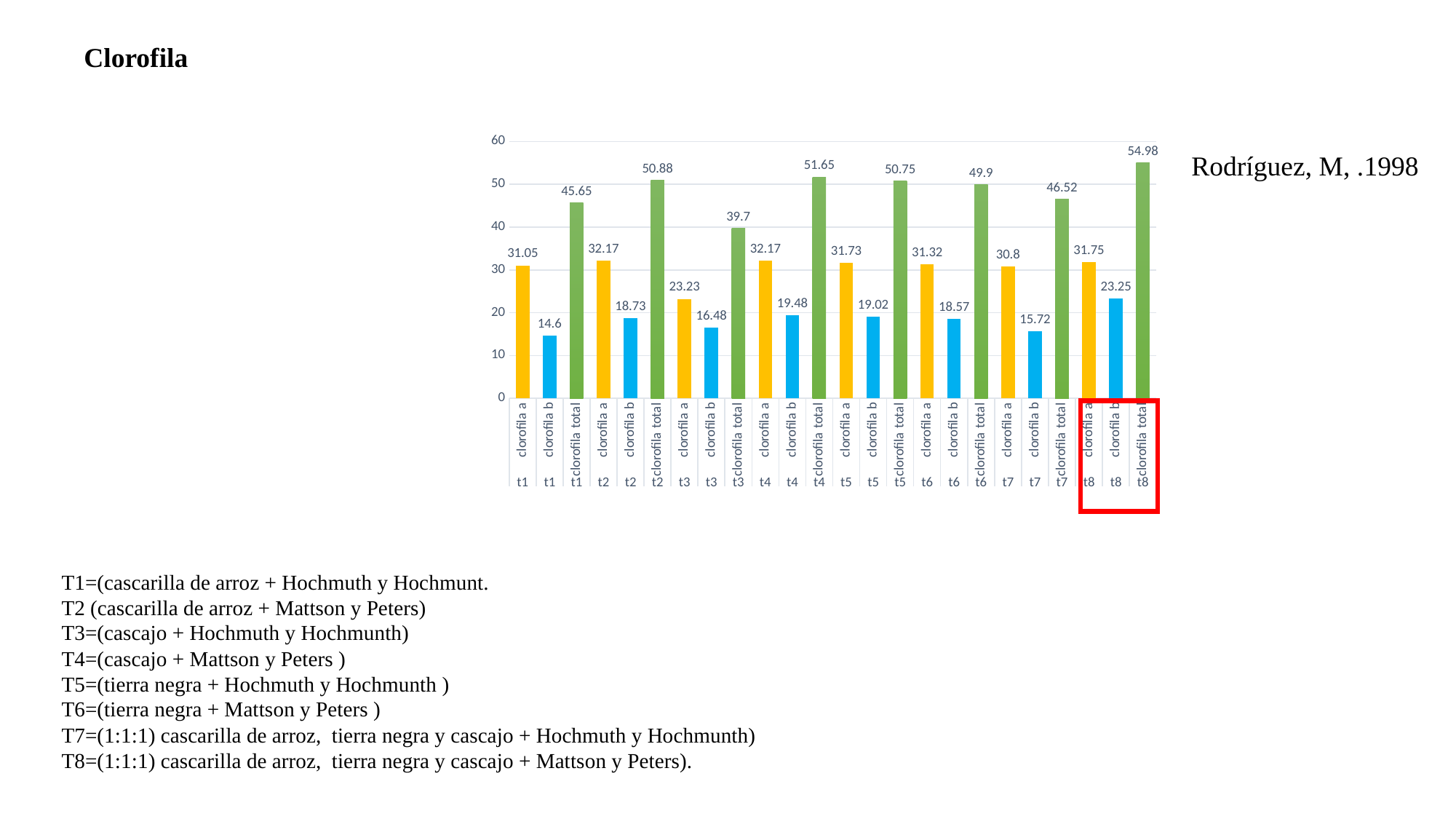
What is the value of clorofila total for t8? 54.98 What is the difference between the clorofila total of t8 and the clorofila total of t3? 15.28 Which treatment has the lowest clorofila total value? t3 Is the clorofila total value for t3 greater or less than 30? greater Which is larger, the clorofila b value for t8 or the clorofila b value for t7? t8 Which treatment has the highest clorofila total value? t8 What kind of chart is shown on the slide? bar chart What is the value of clorofila total for t4? 51.65 Which treatment has the lowest clorofila b value? t1 What is the value of clorofila b for t1? 14.6 How many bars are plotted in the chart? 24 What is the value of clorofila a for t3? 23.23